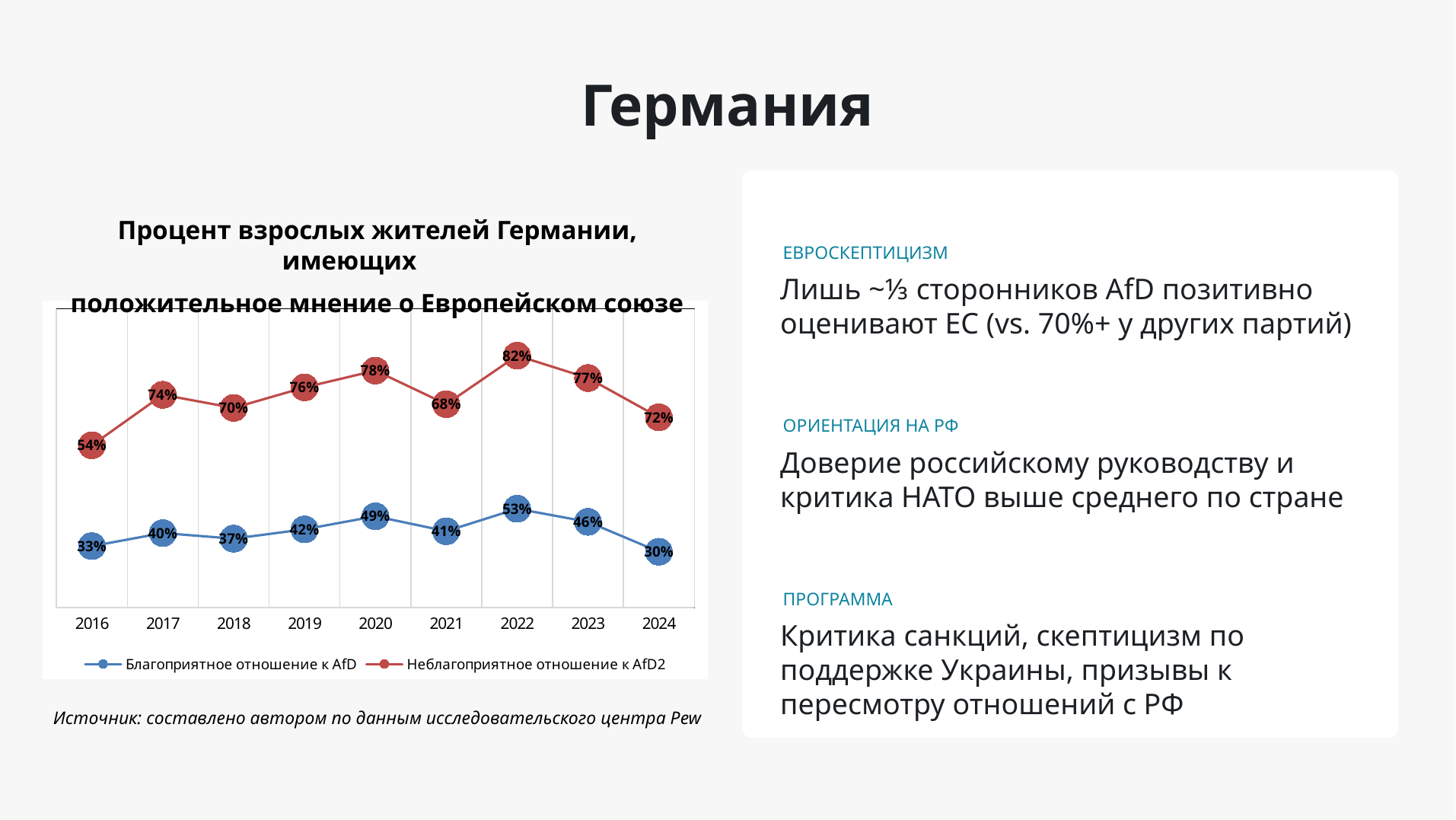
Which is larger in 2021: "Благоприятное отношение к AfD" or "Неблагоприятное отношение к AfD2"? Неблагоприятное отношение к AfD2 How many years are plotted on the x axis? 9 Does "Благоприятное отношение к AfD" rise or fall from 2023 to 2024? Fall What is the value for "Неблагоприятное отношение к AfD2" in 2024? 72% What colour is the line for "Неблагоприятное отношение к AfD2"? Red In which year does "Благоприятное отношение к AfD" reach its highest value? 2022 What is the value for "Благоприятное отношение к AfD" in 2020? 49% How many series does the legend list? 2 What type of chart is shown on the slide? Line chart What is the value for "Неблагоприятное отношение к AfD2" in 2016? 54% What is the difference between "Неблагоприятное отношение к AfD2" and "Благоприятное отношение к AfD" in 2022? 29% In which year is "Неблагоприятное отношение к AfD2" at its lowest? 2016